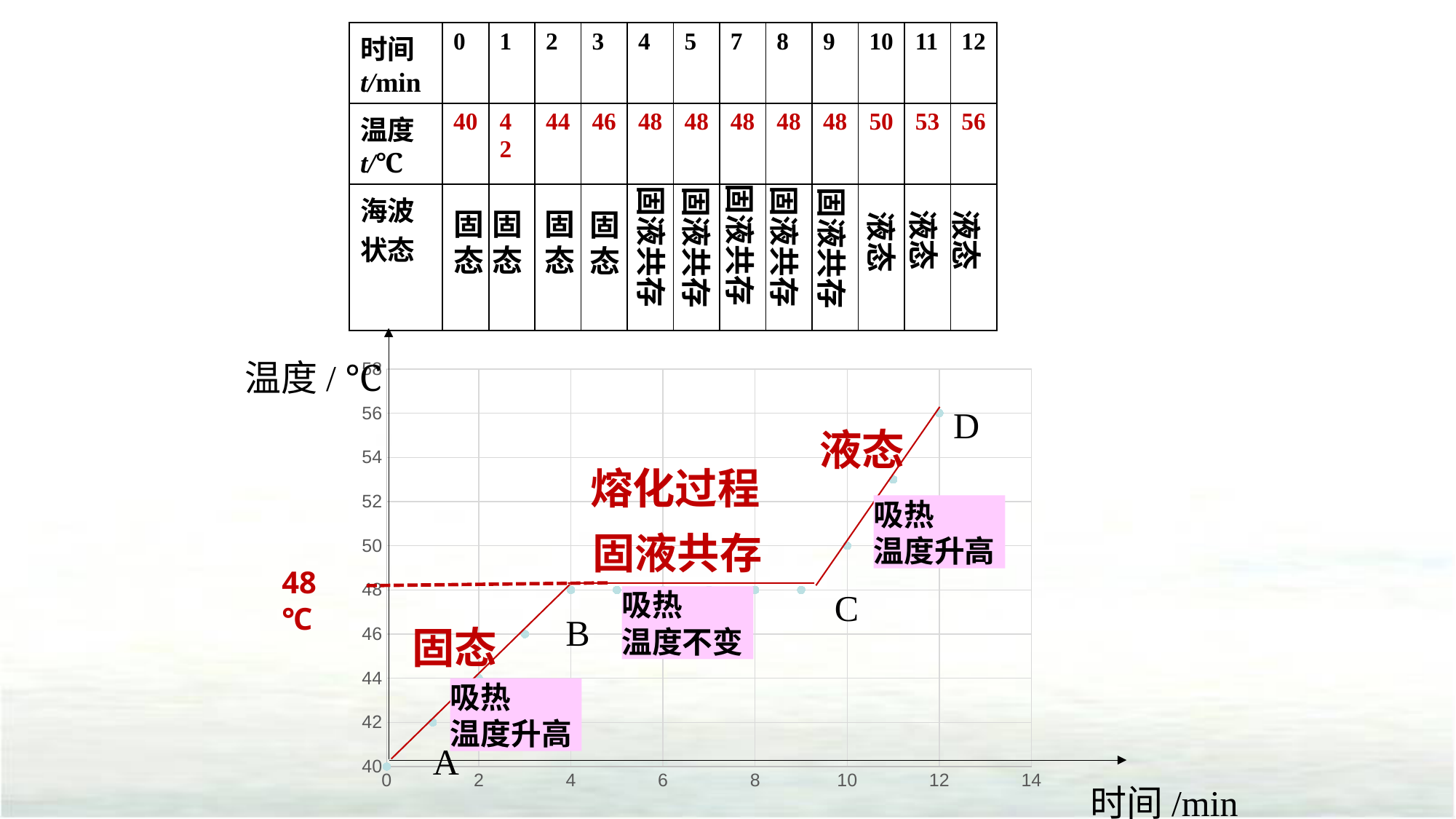
How does the temperature change between 4 min and 9 min? It stays constant at 48 Which is higher, the temperature at 2 min or the temperature at 10 min? 10 min Is the temperature at 11 min greater or less than 52? greater At which time is the temperature highest? 12 min What kind of chart is shown on the slide? line chart What temperature does the horizontal dashed line on the chart mark? 48 ℃ What is the temperature at 0 min? 40 What is the temperature at 10 min? 50 At which time is the temperature lowest? 0 min What is the difference between the temperature at 12 min and the temperature at 0 min? 16 What is the temperature at 4 min? 48 What is the temperature at 12 min? 56